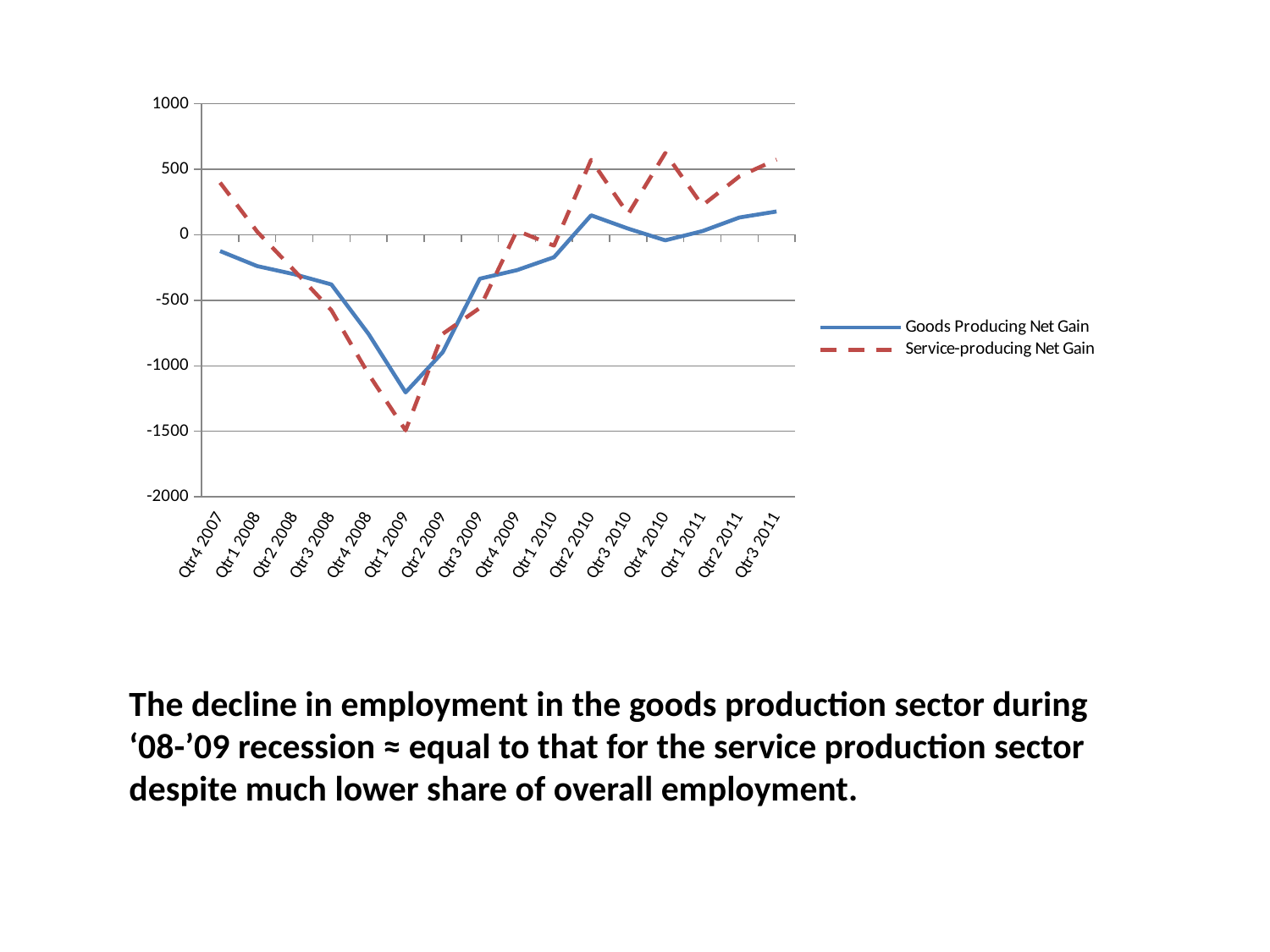
Is the Goods Producing Net Gain value for Qtr1 2009 greater or less than -1000? less How many series does the legend list? 2 In Qtr1 2009, which series has the lower value, Goods Producing Net Gain or Service-producing Net Gain? Service-producing Net Gain In which quarter does the Service-producing Net Gain line reach its lowest point? Qtr1 2009 Is the Service-producing Net Gain value for Qtr2 2010 greater or less than 500? greater In which quarter does the Goods Producing Net Gain line reach its lowest point? Qtr1 2009 Does the Goods Producing Net Gain line rise or fall from Qtr4 2007 to Qtr1 2009? Fall How many quarters are plotted along the x axis? 16 In Qtr4 2007, which series has the higher value, Goods Producing Net Gain or Service-producing Net Gain? Service-producing Net Gain What kind of chart is shown on the slide? Line chart Is the Service-producing Net Gain value for Qtr4 2007 greater or less than 0? greater Which series is drawn with a dashed line? Service-producing Net Gain